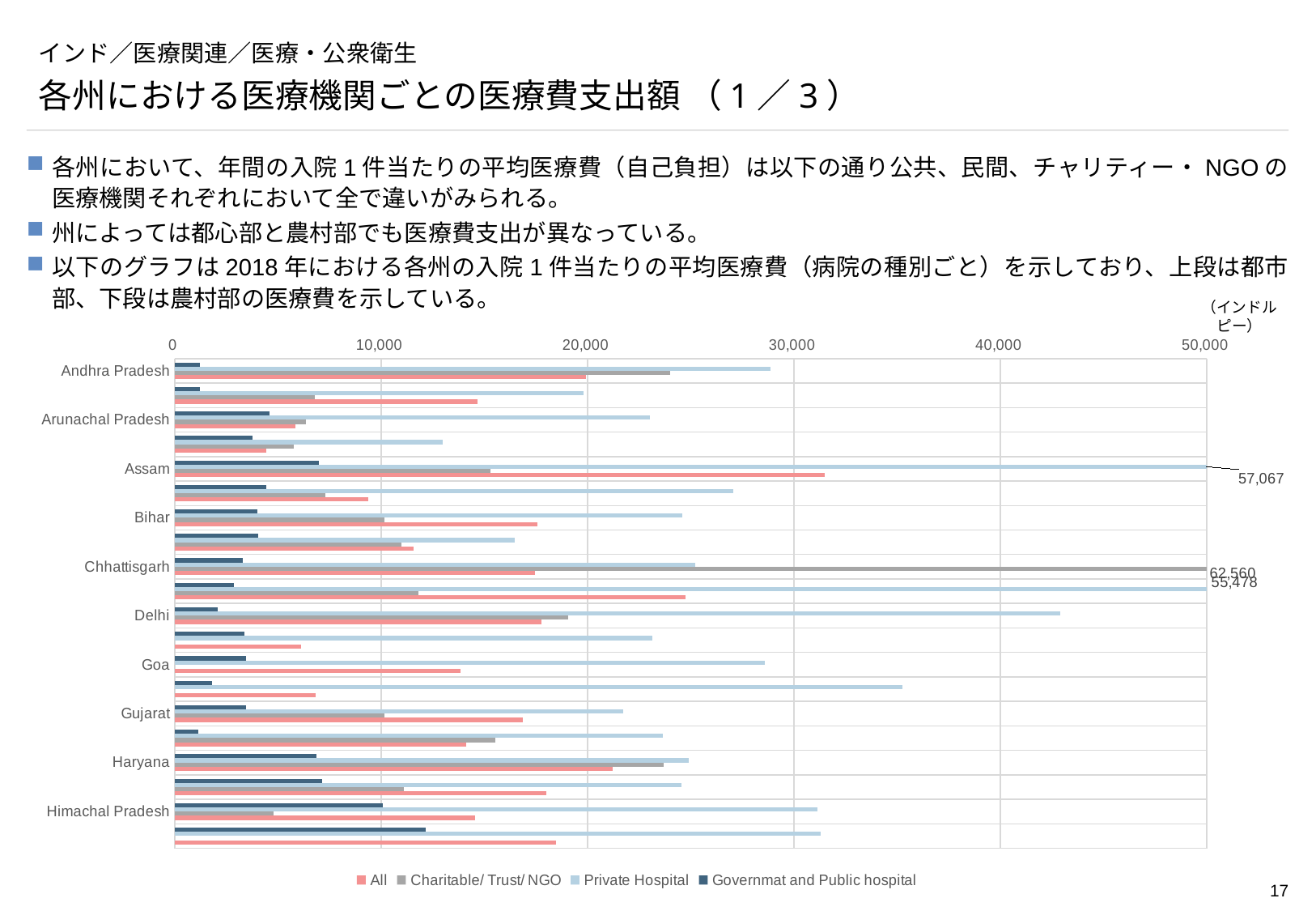
What is the highest tick value shown on the horizontal axis? 50,000 Which state has the longest bar in the chart? Chhattisgarh Is the Private Hospital value for urban Andhra Pradesh greater or less than 20,000? greater What is the difference between the labelled values 62,560 and 55,478 for Chhattisgarh? 7,082 How many states are labelled on the vertical axis of the chart? 10 What is the labelled value of the Private Hospital bar for rural Chhattisgarh? 62,560 How many series does the chart legend list? 4 What is the labelled value of the Private Hospital bar for urban Assam? 57,067 Which is larger, the Governmat and Public hospital value for urban Haryana or for urban Delhi? urban Haryana What kind of chart is shown on the slide? bar chart Is the Private Hospital value for urban Delhi greater or less than 40,000? greater What is the labelled value of the Charitable/ Trust/ NGO bar for urban Chhattisgarh? 55,478